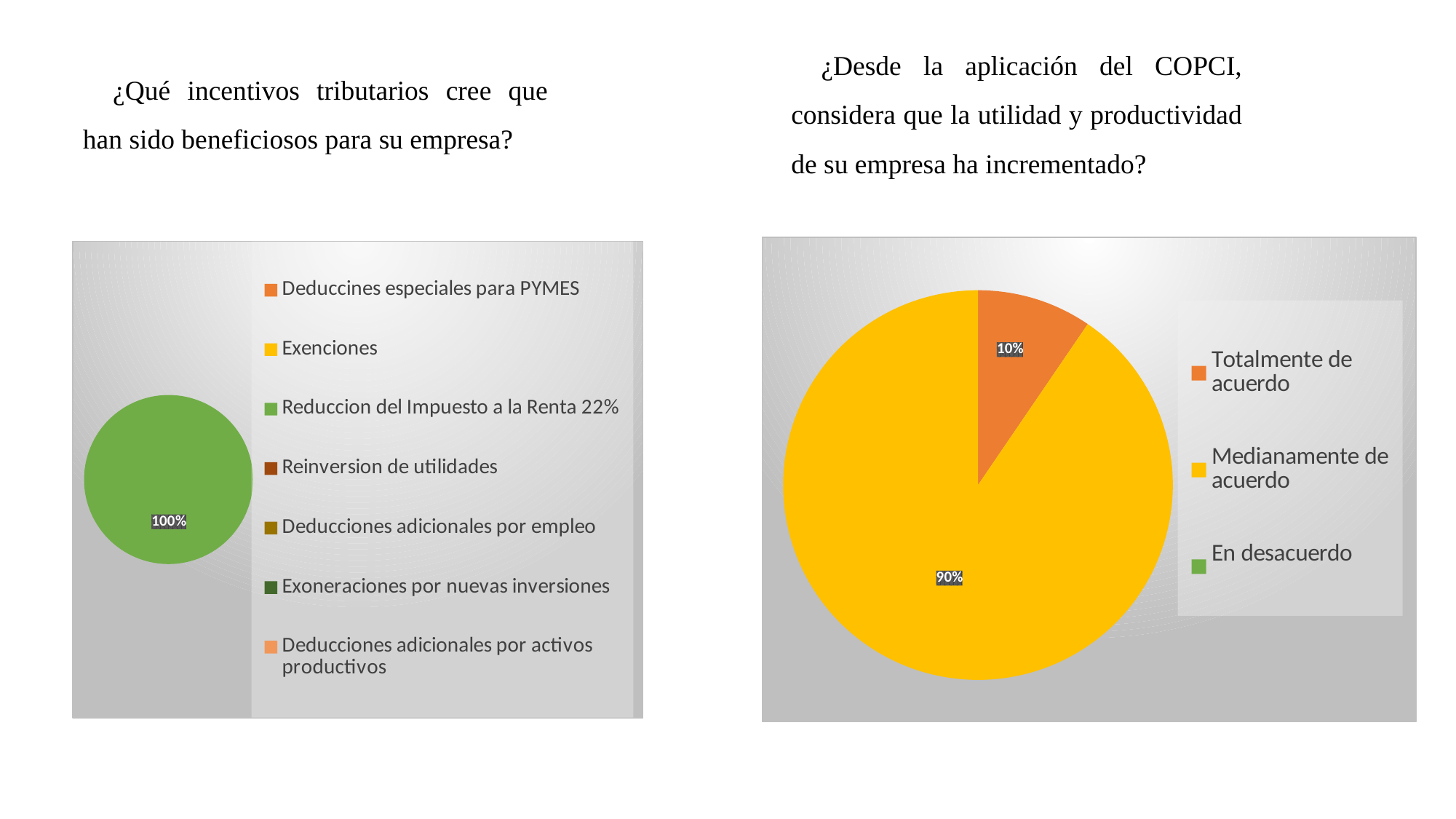
In the right chart about utility and productivity, what share is labelled for 'Medianamente de acuerdo'? 90% In the left chart about tax incentives, what percentage is shown on the single slice? 100% In the right chart about utility and productivity, what share is labelled for 'Totalmente de acuerdo'? 10% How many entries does the legend of the right chart about utility and productivity list? 3 How many entries does the legend of the left chart about tax incentives list? 7 What kind of chart is the left chart about tax incentives? Pie chart In the right chart about utility and productivity, what colour is the 'Totalmente de acuerdo' slice? Orange What kind of chart is the right chart about utility and productivity since COPCI? Pie chart In the right chart about utility and productivity, which is larger: 'Totalmente de acuerdo' or 'Medianamente de acuerdo'? Medianamente de acuerdo In the left chart about tax incentives, which legend entry does the green slice labelled 100% correspond to? Reduccion del Impuesto a la Renta 22% In the right chart about utility and productivity, which category has the largest slice? Medianamente de acuerdo In the right chart about utility and productivity, what is the difference between the 'Medianamente de acuerdo' and 'Totalmente de acuerdo' shares? 80%